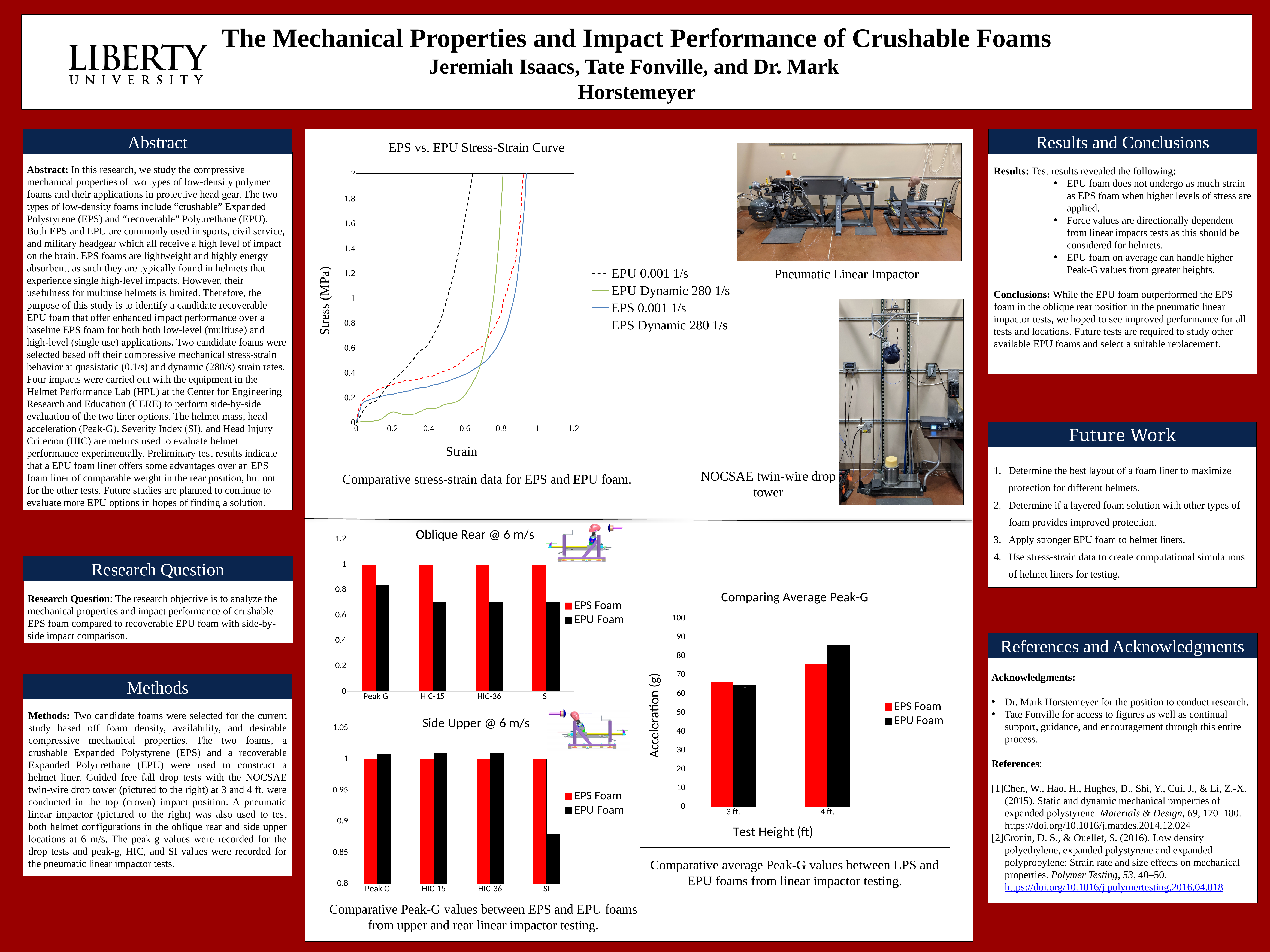
In the "Comparing Average Peak-G" chart, does the EPS Foam value rise or fall from 3 ft. to 4 ft.? rise In the "Side Upper @ 6 m/s" chart, which is larger for SI, EPS Foam or EPU Foam? EPS Foam What is the y-axis label of the "EPS vs. EPU Stress-Strain Curve" chart? Stress (MPa) In the "Oblique Rear @ 6 m/s" chart, which is larger for Peak G, EPS Foam or EPU Foam? EPS Foam In the "Oblique Rear @ 6 m/s" chart, how many categories are shown on the x axis? 4 In the "Comparing Average Peak-G" chart, is the value for EPU Foam at 4 ft. greater or less than 80? greater What kind of chart is the "EPS vs. EPU Stress-Strain Curve"? line chart In the "Oblique Rear @ 6 m/s" chart, is the value for EPU Foam at HIC-15 greater or less than 0.8? less In the "Oblique Rear @ 6 m/s" chart, what is the value for EPS Foam at Peak G? 1 In the "Side Upper @ 6 m/s" chart, is the value for EPU Foam at SI greater or less than 0.9? less In the "Comparing Average Peak-G" chart, how many series does the legend list? 2 How many series does the legend of the "EPS vs. EPU Stress-Strain Curve" chart list? 4